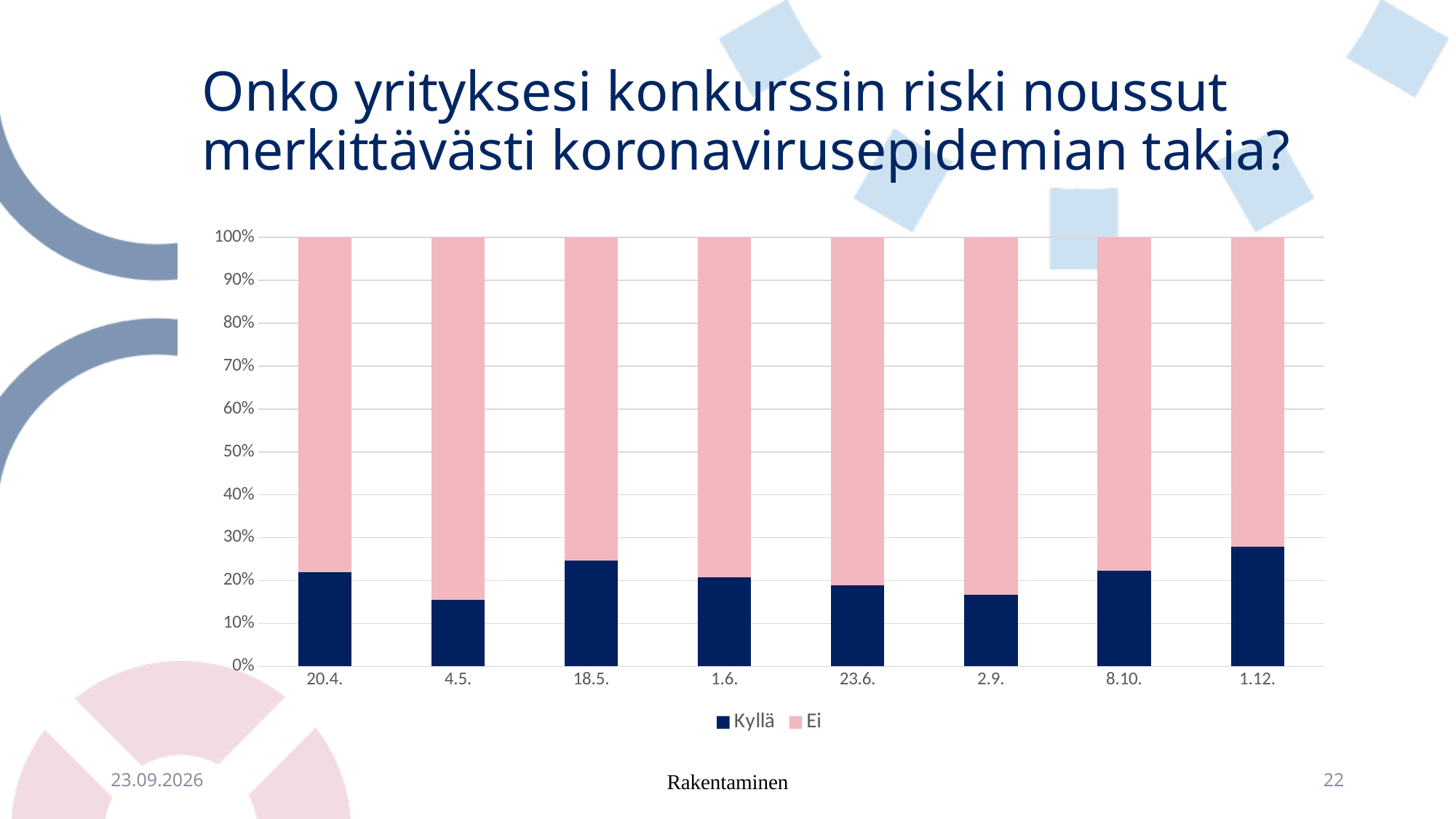
How many dates (categories) are shown on the x axis? 8 How many series does the legend list? 2 What are the two series named in the legend? Kyllä and Ei Is the Ei value for 2.9. greater or less than 80%? greater Is the Kyllä value for 4.5. greater or less than 20%? less Is the Kyllä value for 18.5. greater or less than 20%? greater On which date is the Kyllä share the highest? 1.12. Which has the larger Kyllä share, 1.12. or 4.5.? 1.12. What kind of chart is shown on the slide? bar chart Which colour represents the Kyllä series? dark blue What is the total of the stacked bar for 20.4.? 100%